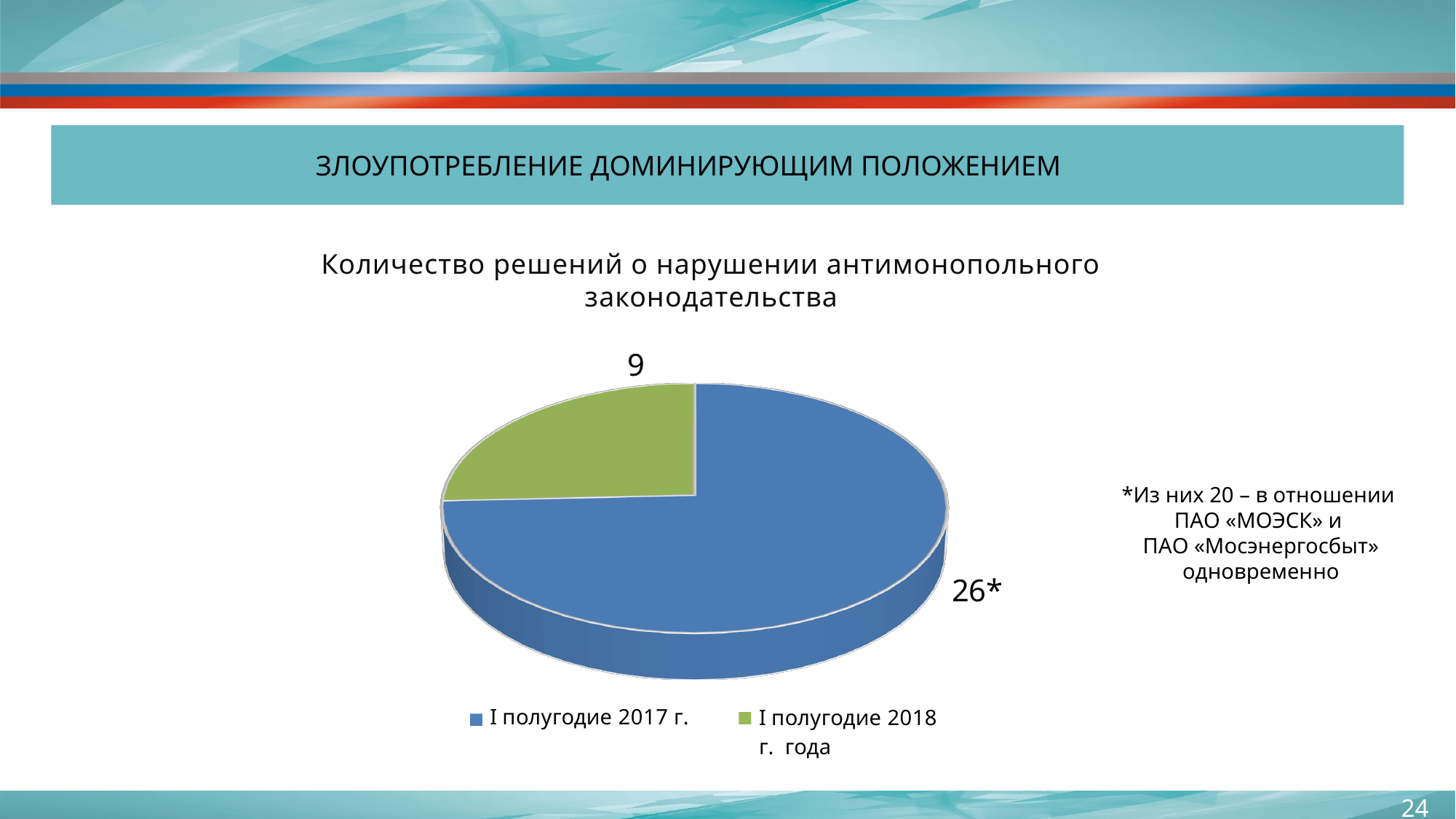
Is the value for I полугодие 2017 г. larger or smaller than the value for I полугодие 2018 г.? larger What is the difference between the values for I полугодие 2017 г. and I полугодие 2018 г.? 17 What is the value for I полугодие 2017 г.? 26* Which period has the smaller slice of the pie? I полугодие 2018 г. What is the value for I полугодие 2018 г.? 9 How many entries does the legend list? 2 How many slices does the pie chart have? 2 What colour is the slice for I полугодие 2018 г.? green What type of chart is shown on the slide? pie chart Which period has the larger slice of the pie? I полугодие 2017 г. What is the total of the two values shown in the pie chart? 35 What is the title of the chart? Количество решений о нарушении антимонопольного законодательства